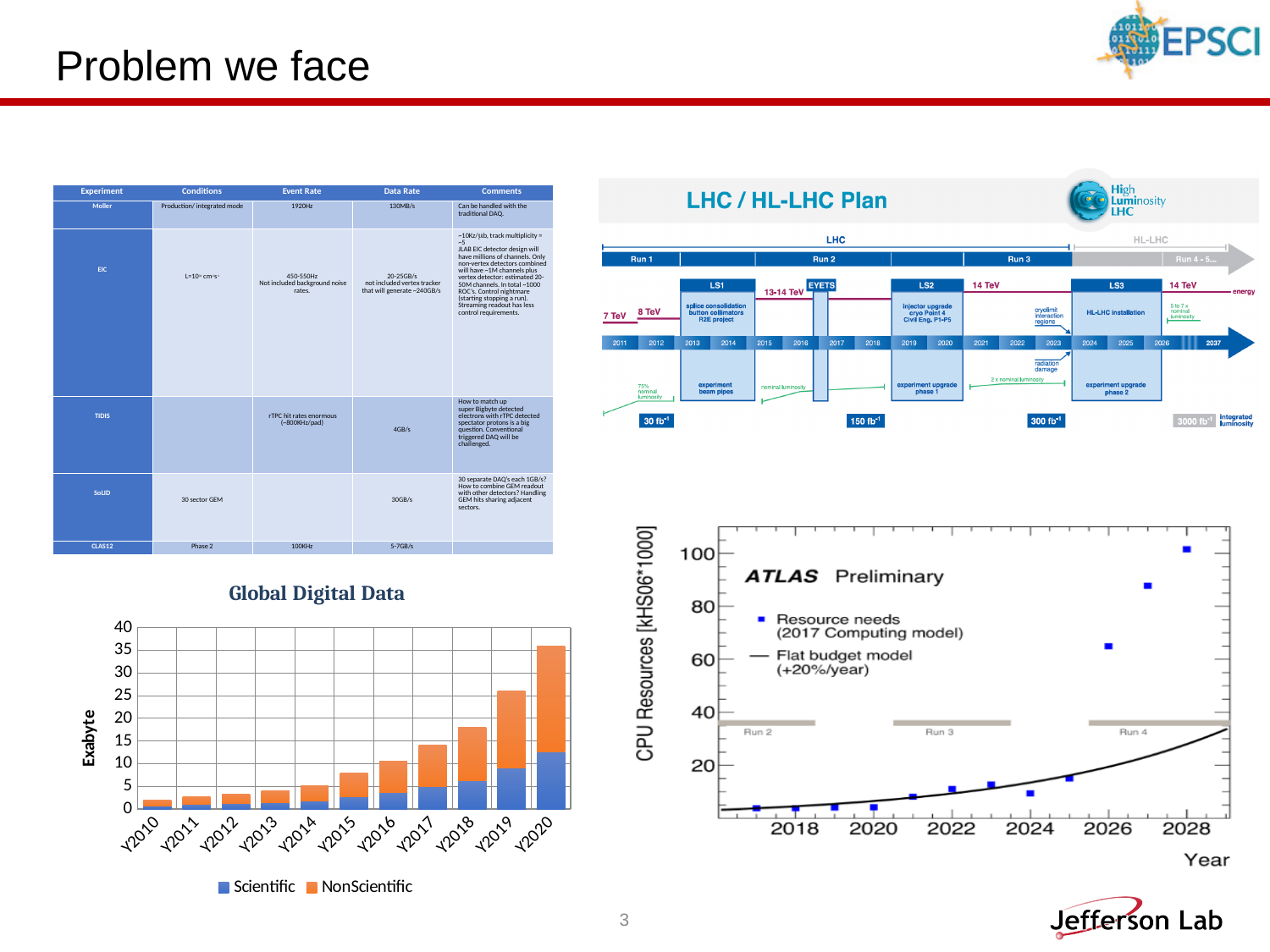
In the 'Global Digital Data' chart, what colour represents the Scientific series? blue Do the totals in the 'Global Digital Data' chart rise or fall from Y2010 to Y2020? rise How many series does the legend of the 'Global Digital Data' chart list? 2 What is the y-axis label of the 'ATLAS Preliminary' chart on the lower right? CPU Resources [kHS06*1000] In the 'Global Digital Data' chart, is the total for Y2018 greater or less than 20 Exabyte? less In the 'Global Digital Data' chart, which year has the lowest total? Y2010 In the 'Global Digital Data' chart, which year has the highest total? Y2020 How many years are shown on the x axis of the 'Global Digital Data' chart? 11 In the 'ATLAS Preliminary' chart, is the Resource needs value for 2027 greater or less than 80? greater What type of chart is the 'Global Digital Data' chart? stacked bar chart In the 'Global Digital Data' chart, which series is larger in Y2020, Scientific or NonScientific? NonScientific In the 'Global Digital Data' chart, is the total for Y2020 greater or less than 30 Exabyte? greater